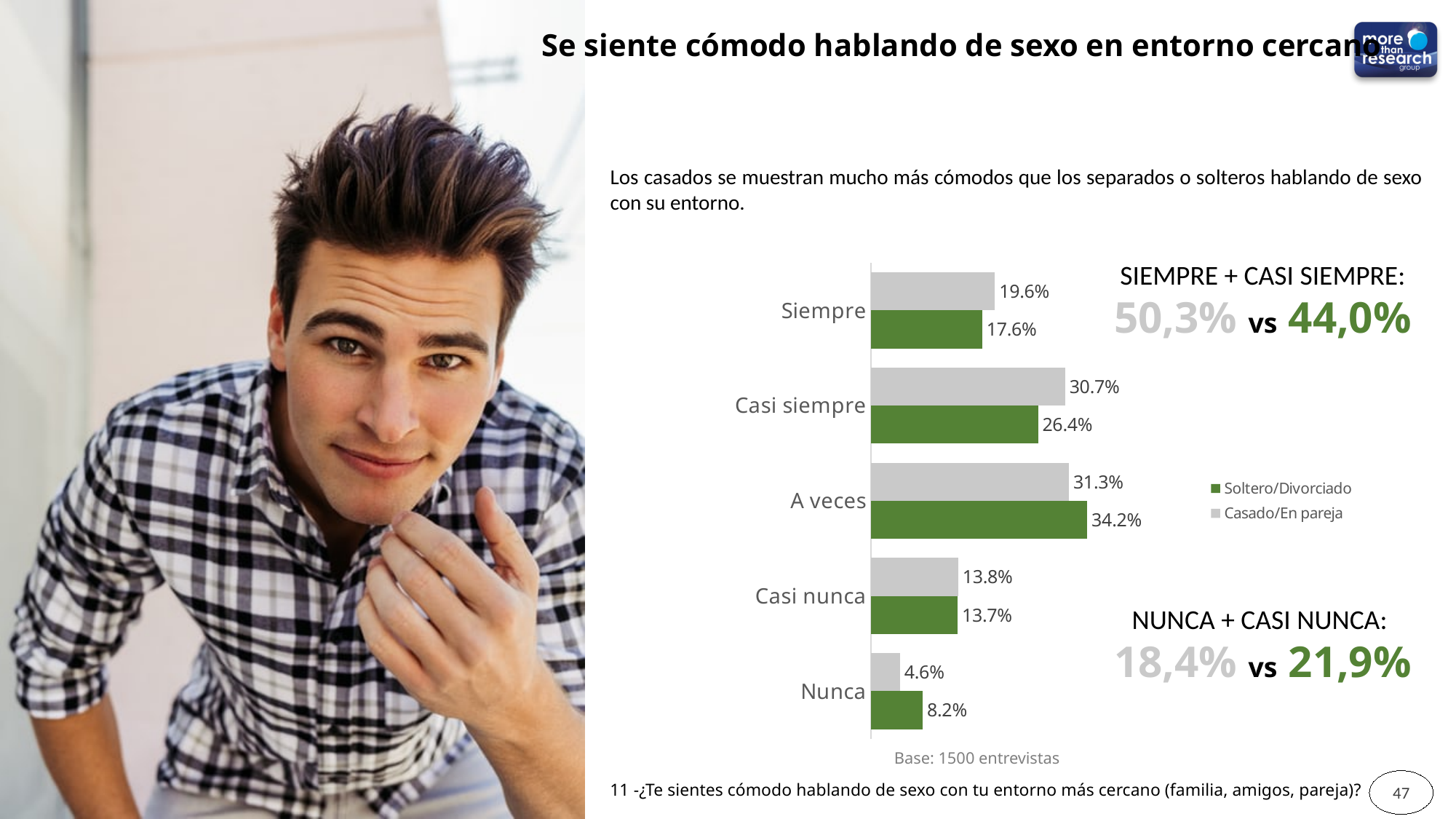
Which category has the lowest value for Casado/En pareja? Nunca What is the value for Soltero/Divorciado in the A veces category? 34.2% What is the difference between Casado/En pareja and Soltero/Divorciado in the Casi siempre category? 4.3% What is the value for Casado/En pareja in the Siempre category? 19.6% In the Nunca category, which series has the larger value, Soltero/Divorciado or Casado/En pareja? Soltero/Divorciado What kind of chart is shown on the slide? Bar chart What is the value for Casado/En pareja in the Casi siempre category? 30.7% Which category has the highest value for Soltero/Divorciado? A veces What is the value for Soltero/Divorciado in the Nunca category? 8.2% How many series does the legend list? 2 How many categories are shown on the chart? 5 Which colour represents the Soltero/Divorciado series? Green